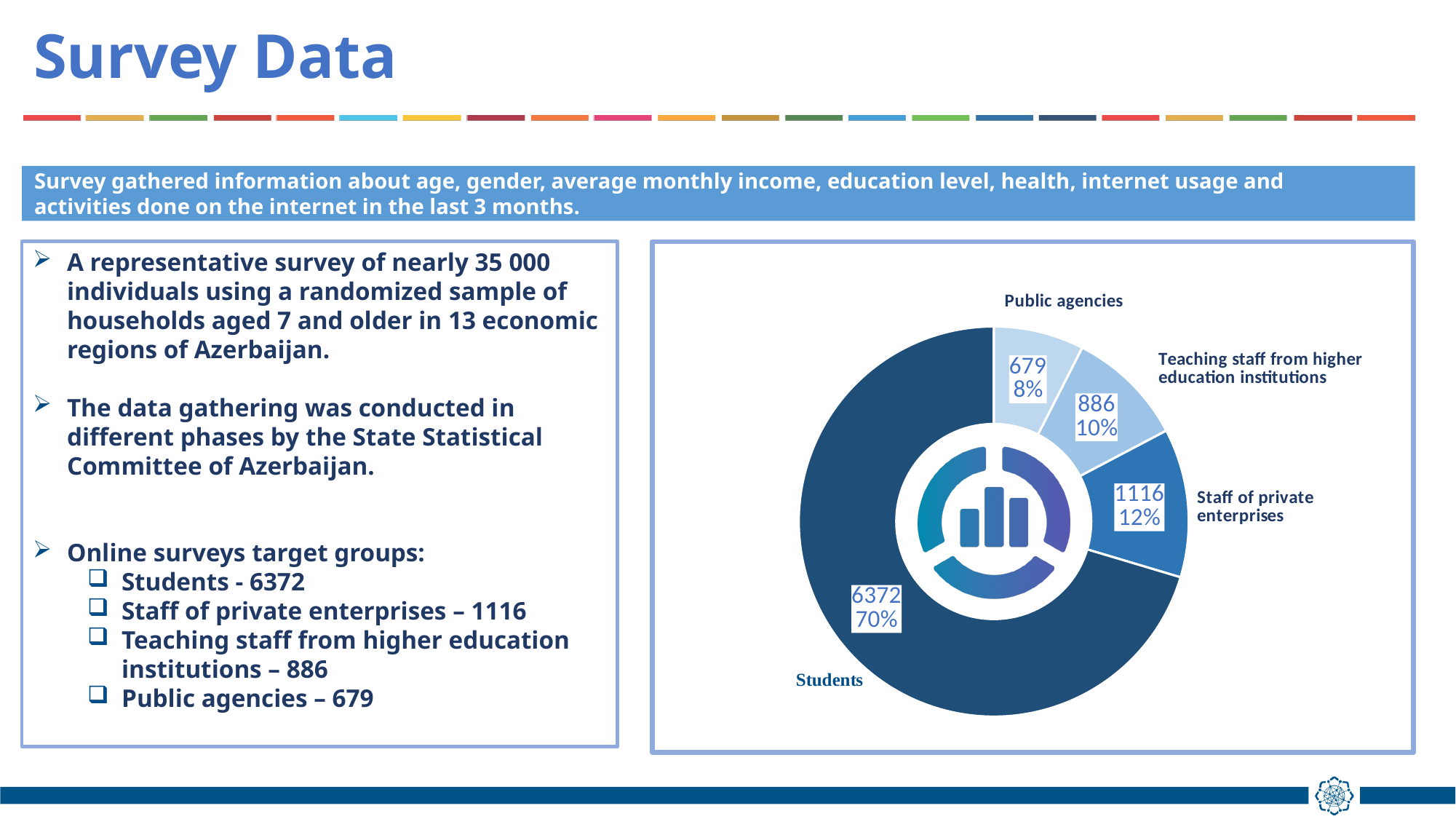
What kind of chart is shown on the slide? Doughnut chart What is the value for Students in the pie chart? 6372 What is the value for Public agencies in the pie chart? 679 What is the value for Teaching staff from higher education institutions in the pie chart? 886 Which category has the largest slice in the pie chart? Students What is the value for Staff of private enterprises in the pie chart? 1116 What share of the pie does Students represent? 70% Which is larger, the value for Staff of private enterprises or the value for Teaching staff from higher education institutions? Staff of private enterprises What is the difference between the values for Staff of private enterprises and Public agencies? 437 Which category has the smallest slice in the pie chart? Public agencies What share of the pie does Teaching staff from higher education institutions represent? 10% How many categories does the pie chart show? 4